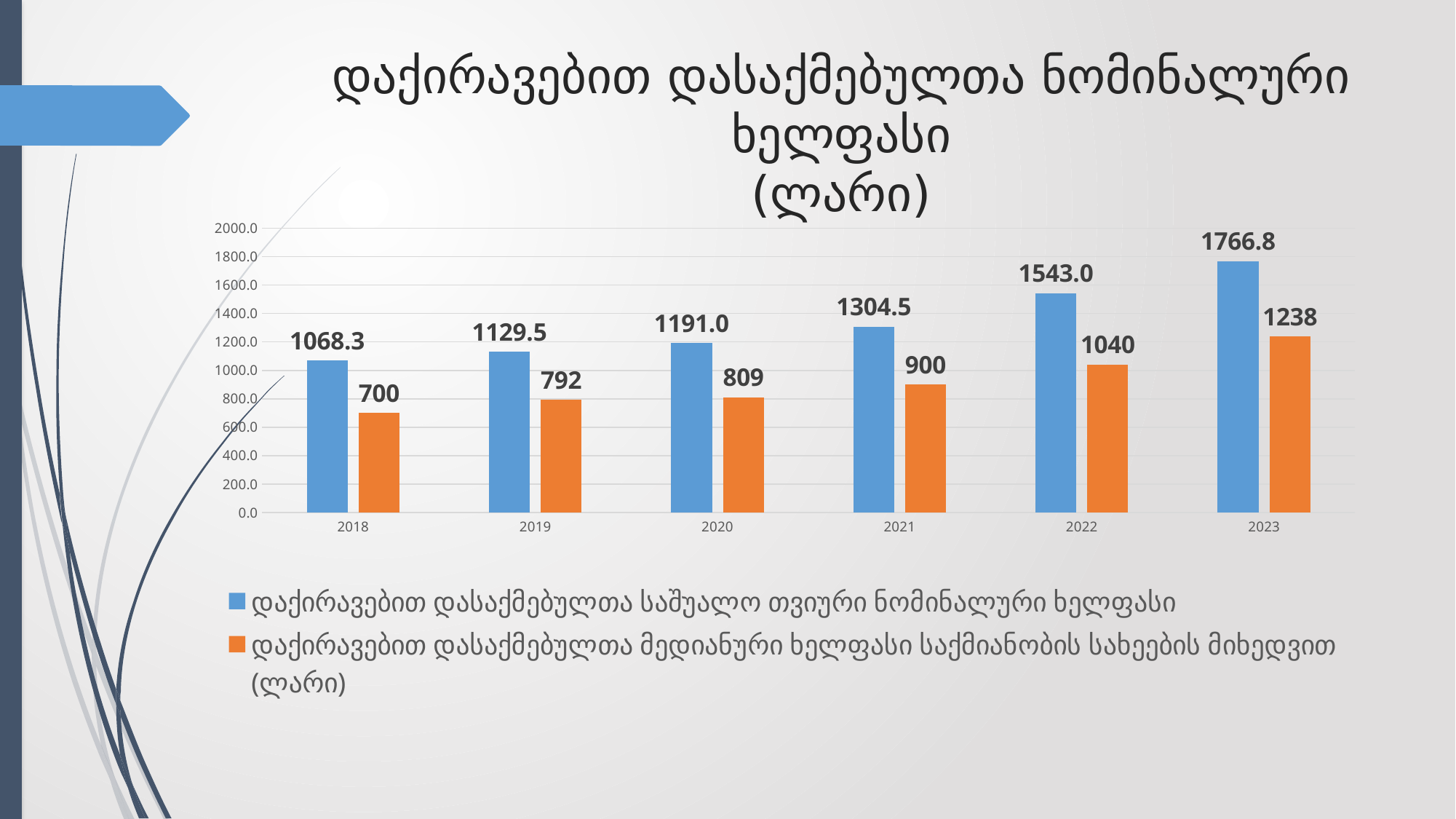
How many series does the legend list? 2 What is the difference between the blue bar and the orange bar in 2021? 404.5 Do the values of the blue series rise or fall from 2018 to 2023? Rise In which year is the blue series (average monthly nominal wage) highest? 2023 What is the value of the orange bar (median wage) for 2018? 700 In which year is the orange series (median wage) lowest? 2018 How many years are shown on the x axis? 6 Which is larger: the orange bar for 2023 or the blue bar for 2019? The orange bar for 2023 (1238) What is the value of the blue bar (average monthly nominal wage) for 2023? 1766.8 What is the value of the blue bar for 2020? 1191.0 What is the value of the orange bar for 2022? 1040 What kind of chart is shown on the slide? Bar chart